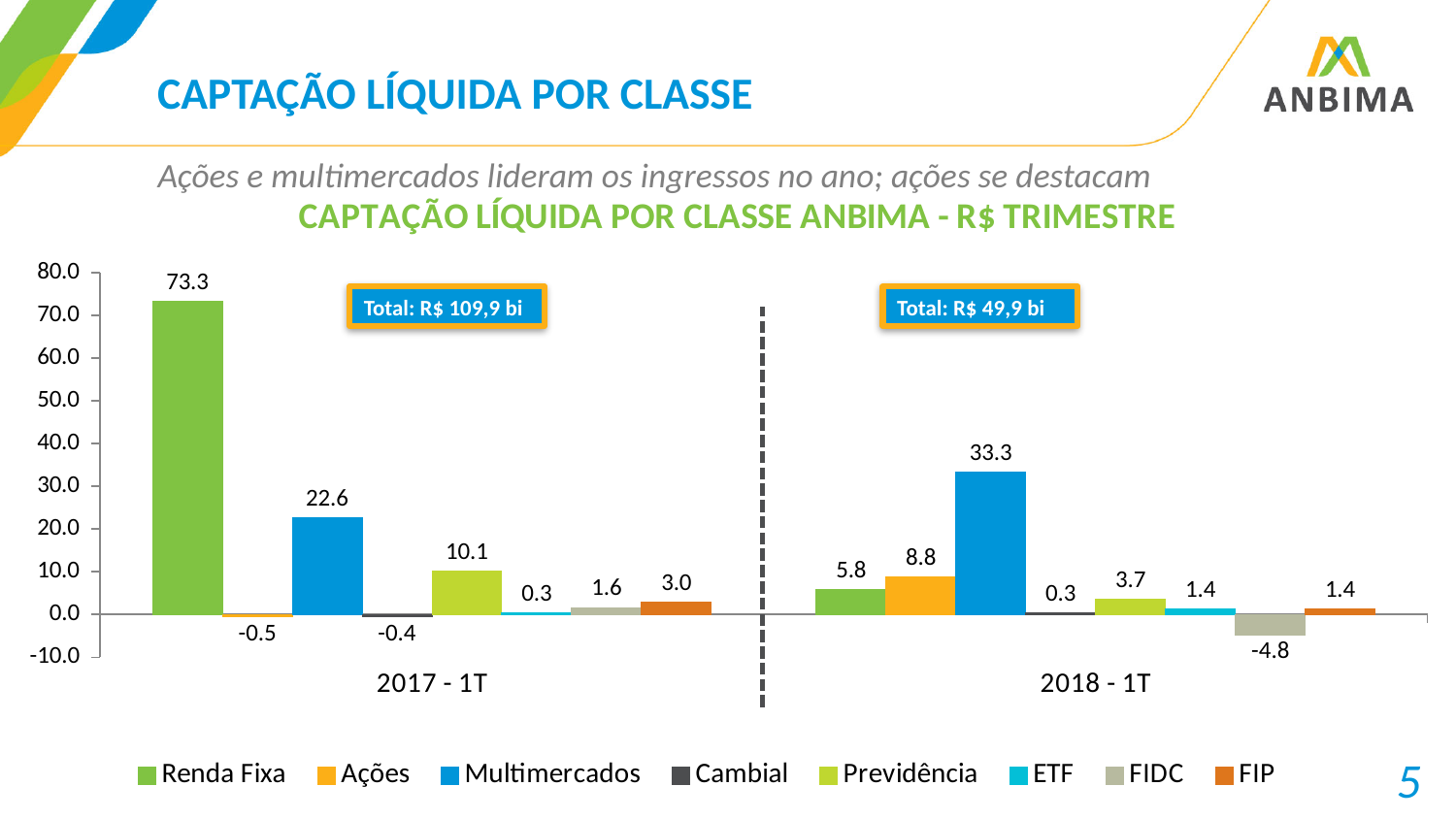
Which series has the lowest value in 2018 - 1T? FIDC What kind of chart is shown on the slide? Bar chart What is the value for FIDC in 2018 - 1T? -4.8 What is the value for Renda Fixa in 2017 - 1T? 73.3 What is the value for Multimercados in 2018 - 1T? 33.3 What total is shown in the box above the 2018 - 1T group? Total: R$ 49,9 bi Which series has the highest value in 2018 - 1T? Multimercados What is the value for Previdência in 2017 - 1T? 10.1 How many series does the legend list? 8 What is the difference between Renda Fixa in 2017 - 1T and Renda Fixa in 2018 - 1T? 67.5 Which is larger: Ações in 2018 - 1T or Previdência in 2018 - 1T? Ações in 2018 - 1T How many period categories are shown on the x axis? 2